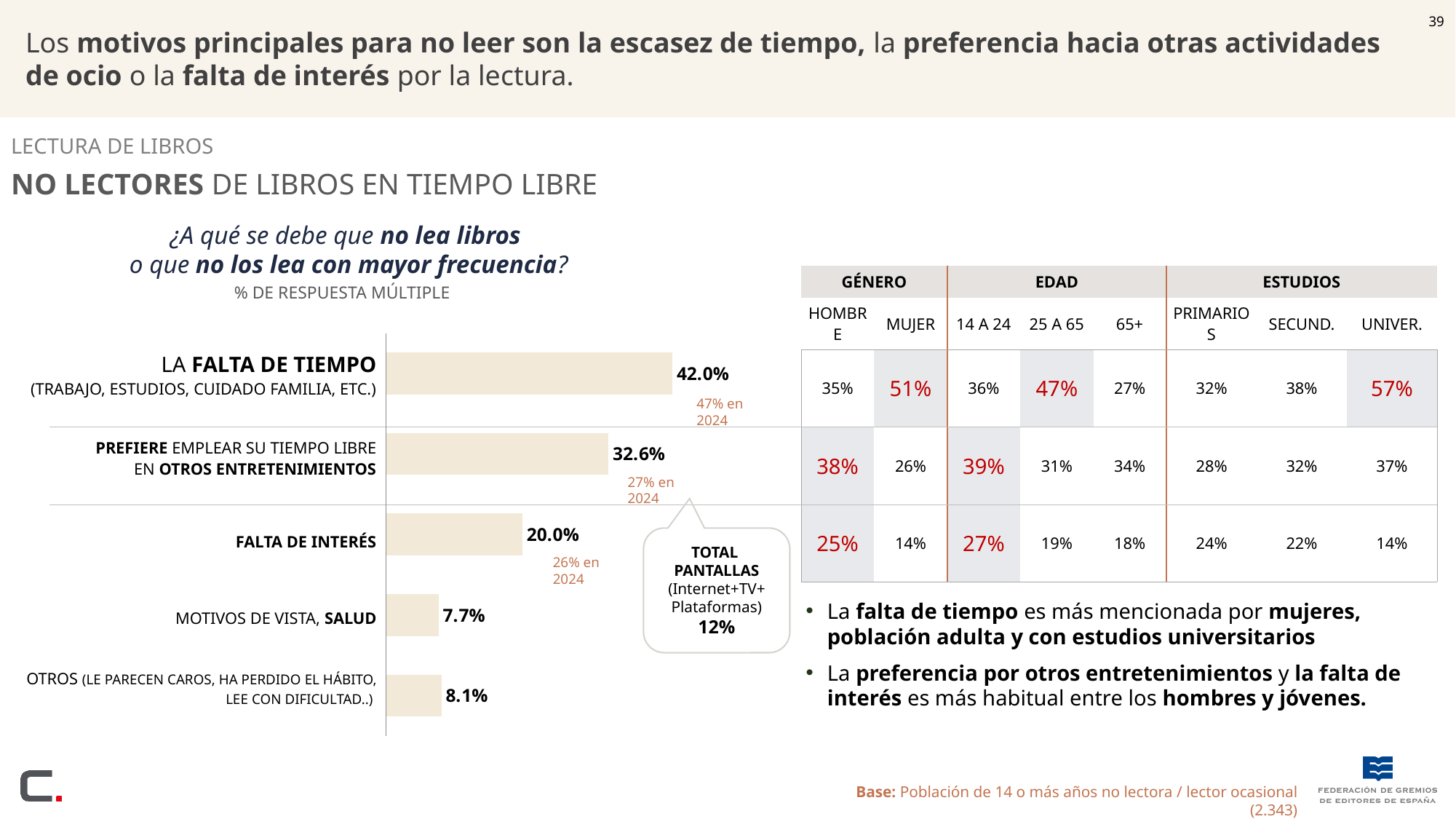
What is the value for 'Motivos de vista, salud'? 7.7% Which is larger: the value for 'Otros' or the value for 'Motivos de vista, salud'? Otros What is the 'Total pantallas (Internet+TV+Plataformas)' value shown in the callout? 12% What percentage of respondents cite 'La falta de tiempo' as a reason for not reading books? 42.0% What was the value for 'La falta de tiempo' in 2024, according to the annotation? 47% What is the difference between the percentages for 'La falta de tiempo' and 'Falta de interés'? 22.0% What percentage is shown for 'Falta de interés'? 20.0% Which reason for not reading has the lowest percentage? Motivos de vista, salud Which reason for not reading has the highest percentage? La falta de tiempo How many reasons (categories) are plotted in the bar chart? 5 What is the value for 'Prefiere emplear su tiempo libre en otros entretenimientos'? 32.6% What type of chart is used to show the reasons for not reading books? Bar chart